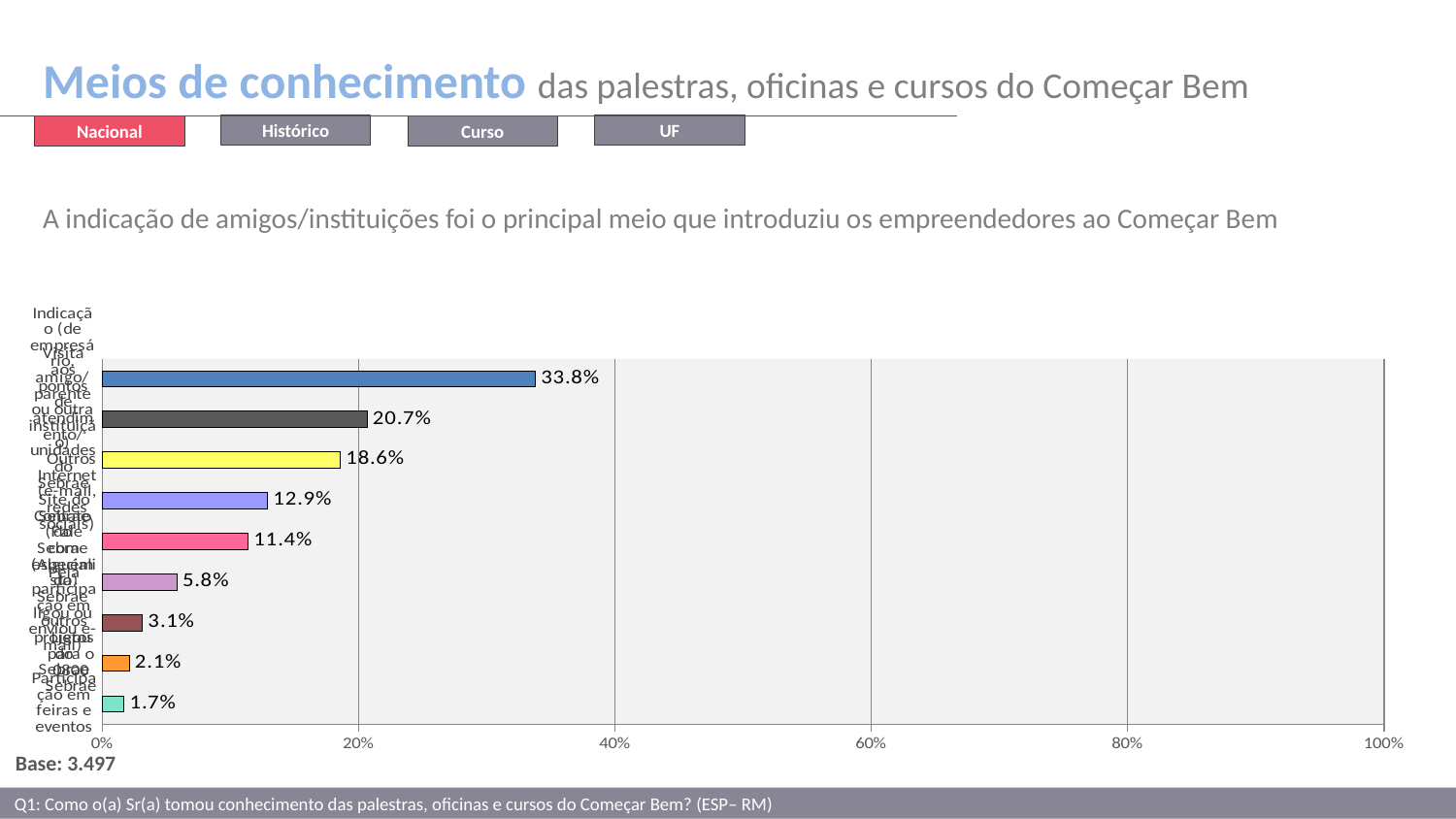
What kind of chart is shown on the slide? bar chart What is the highest value shown in the chart? 33.8% What is the lowest value shown in the chart? 1.7% Is the value of the topmost bar greater or less than 40%? less Which is larger: the value of the dark grey bar or the value of the yellow bar? the dark grey bar (20.7%) What is the value of the yellow bar in the chart? 18.6% What is the difference between the top bar (33.8%) and the second bar (20.7%)? 13.1% How many bars does the chart contain? 9 What is the maximum value shown on the horizontal axis of the chart? 100% What is the value of the pink bar in the chart? 11.4% What is the value of the topmost (blue) bar in the chart? 33.8% Do the bar values increase or decrease from the top of the chart to the bottom? decrease